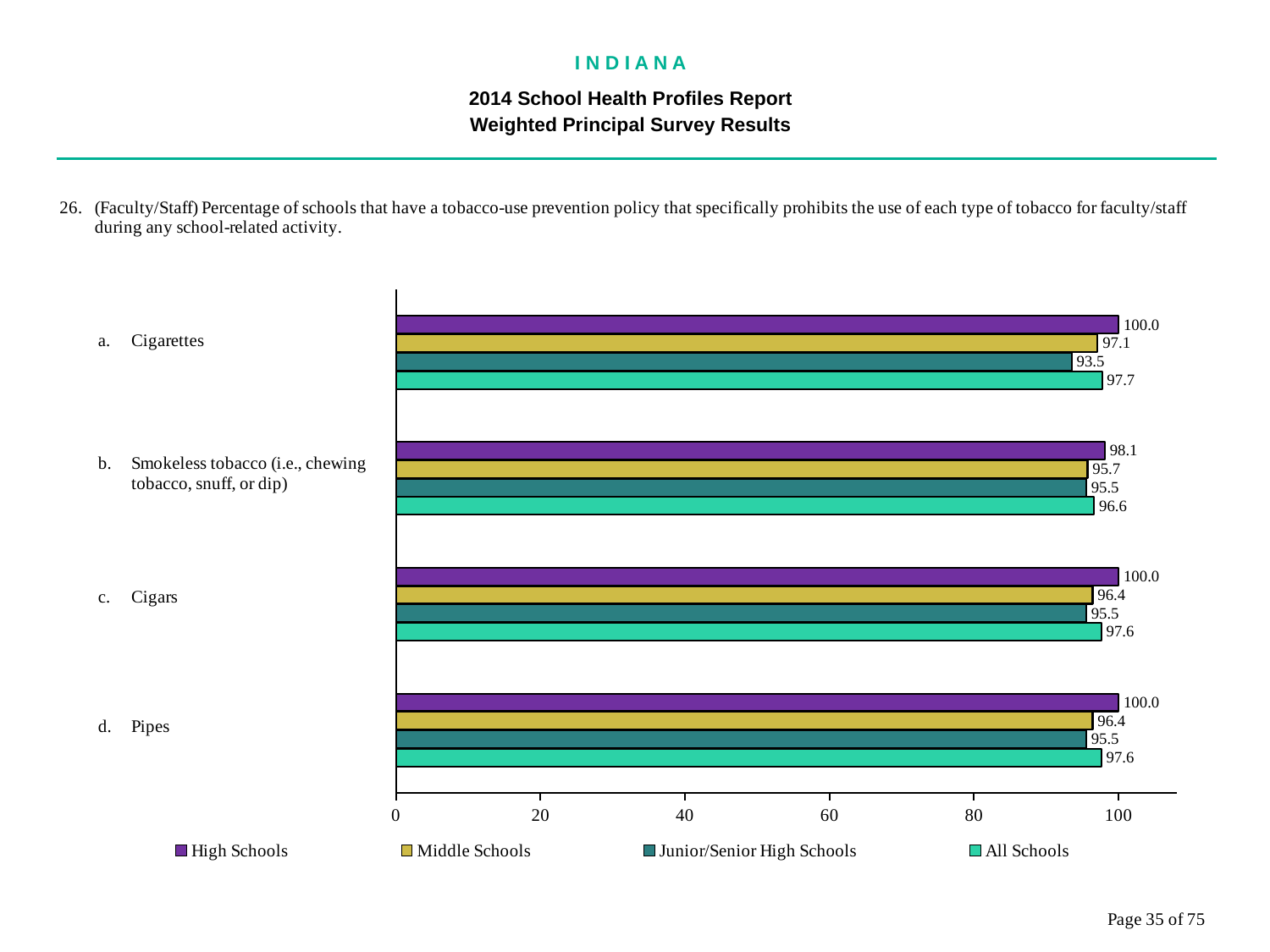
What is the value for High Schools for Cigarettes? 100.0 What is the difference between the High Schools and Junior/Senior High Schools values for Cigarettes? 6.5 What kind of chart is shown on the slide? Bar chart How many series does the legend list? 4 How many categories are shown on the chart? 4 What is the value for All Schools for Pipes? 97.6 Which category has the lowest value for High Schools? Smokeless tobacco (i.e., chewing tobacco, snuff, or dip) What is the value for Middle Schools for Smokeless tobacco? 95.7 Which category has the lowest value for Junior/Senior High Schools? Cigarettes Which is larger for Cigars: the Middle Schools value or the All Schools value? All Schools Which series is shown in purple in the legend? High Schools What is the value for Junior/Senior High Schools for Cigarettes? 93.5